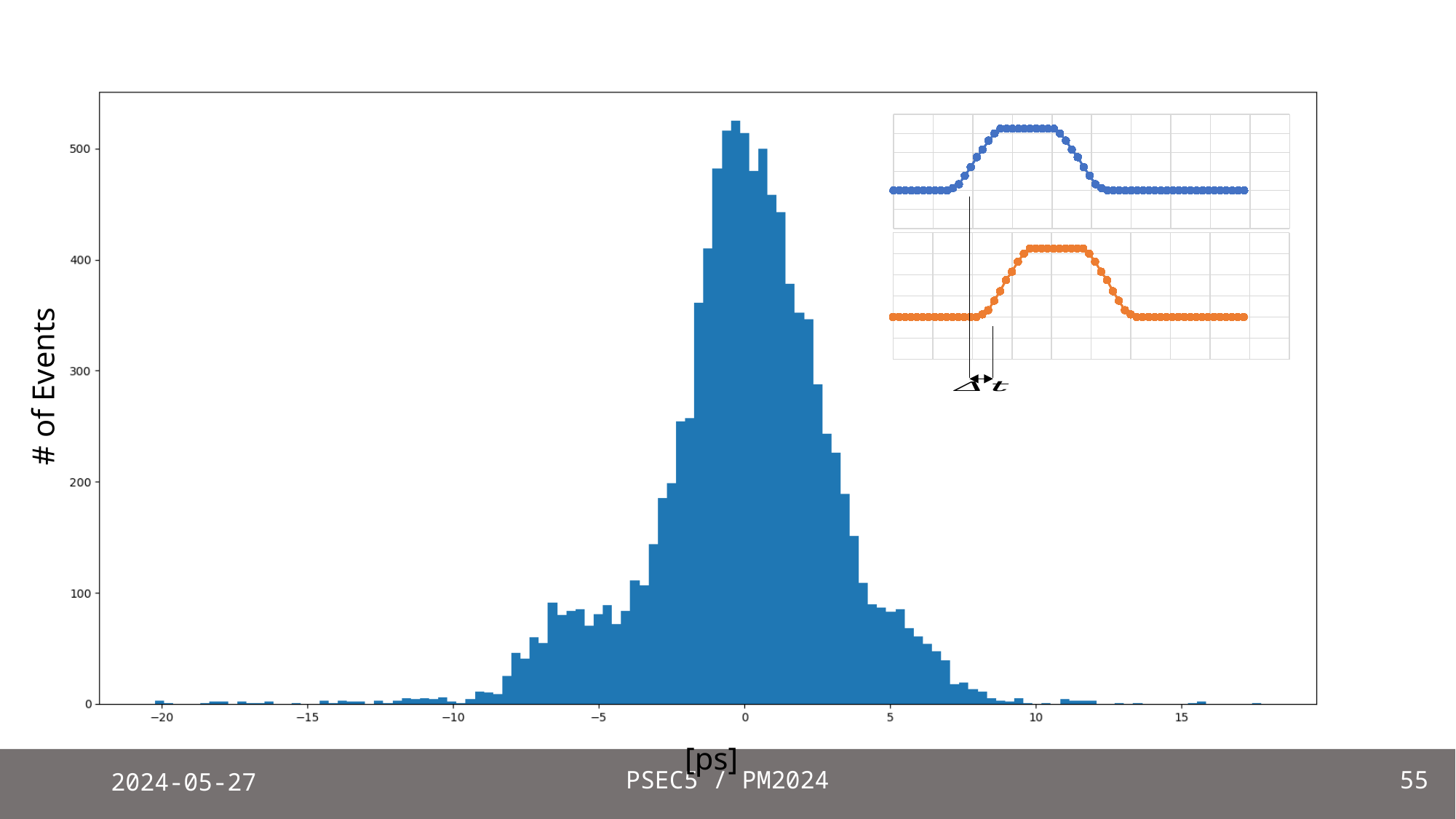
What unit is shown on the x axis of the main chart? [ps] Do the bar heights rise or fall as the x axis goes from -10 ps to 0 ps? rise Is the bar height at about -5 ps greater or less than 100 events? less What is the label of the y axis of the main chart? # of Events Is the bar height at about 10 ps greater or less than 100 events? less How many waveform traces are shown in the inset plot at the top right? 2 Is the bar height at about 5 ps greater or less than 200 events? less Do the bar heights rise or fall as the x axis goes from 0 ps to 10 ps? fall What kind of chart is the main plot on the slide? bar chart (histogram) Near which x-axis tick value does the histogram reach its highest bar? 0